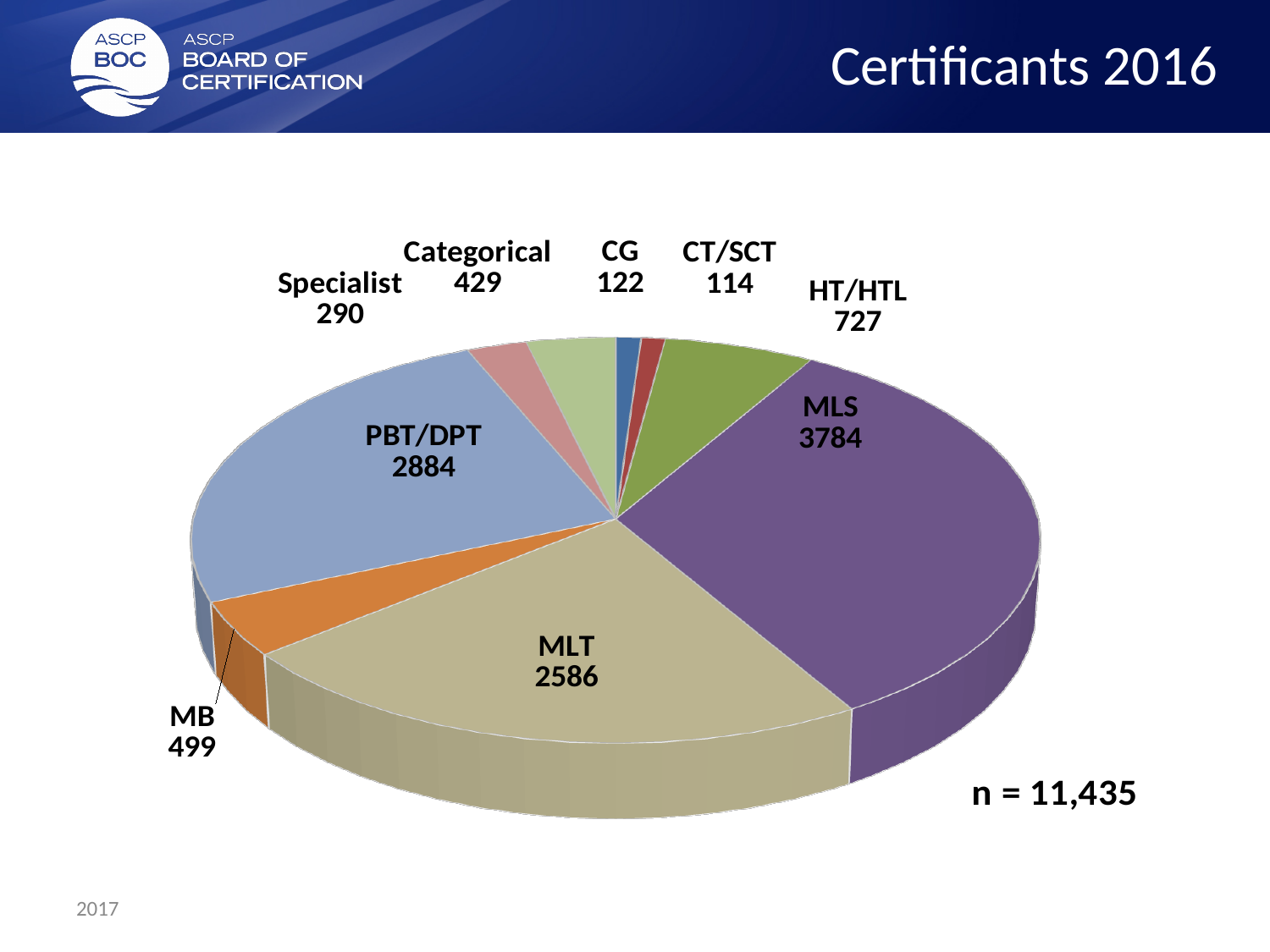
Which category has the largest number of certificants? MLS What type of chart is shown on the slide? Pie chart Which is larger, the value for CG or the value for CT/SCT? CG What is the value shown for PBT/DPT? 2884 What is the title of the slide containing the pie chart? Certificants 2016 What is the value shown for HT/HTL? 727 What is the difference between the PBT/DPT and MLT values? 298 What is the difference between the MLS and PBT/DPT values? 900 How many certificants are in the MLS category? 3784 How many categories are shown in the pie chart? 9 What is the total number of certificants (n) shown on the slide? 11,435 Which category has the smallest number of certificants? CT/SCT